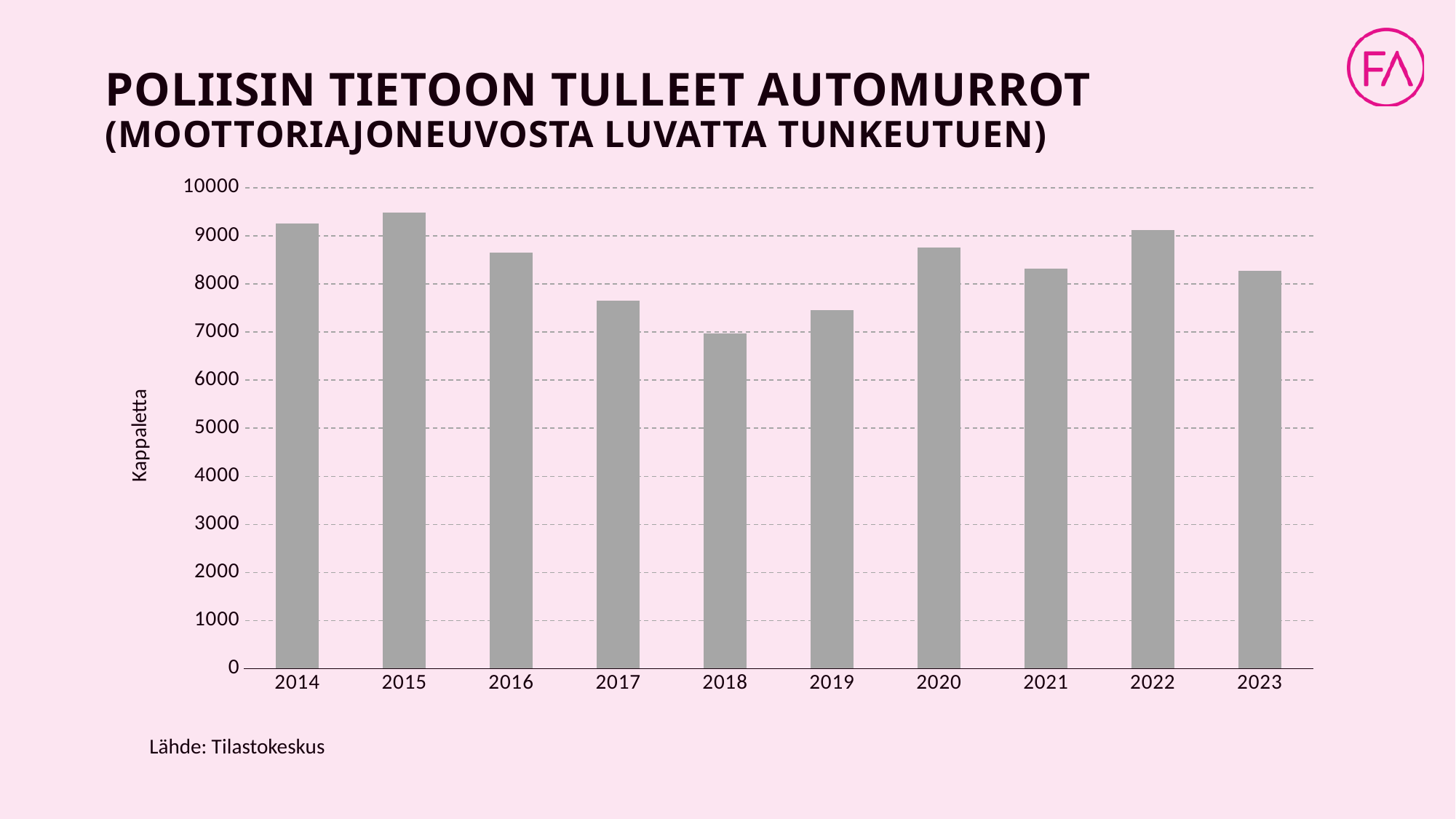
Do the values rise or fall from 2015 to 2018? fall Is the value for 2019 greater or less than 8000? less How many years are shown on the x axis of the chart? 10 Which year has the highest number of car break-ins in the chart? 2015 What kind of chart is shown on the slide? bar chart Is the value for 2014 greater or less than 9000? greater Which year has the lowest number of car break-ins in the chart? 2018 Which is larger, the value for 2014 or the value for 2016? 2014 What is the label on the vertical axis of the chart? Kappaletta Which is larger, the value for 2020 or the value for 2022? 2022 Is the value for 2017 greater or less than 7000? greater